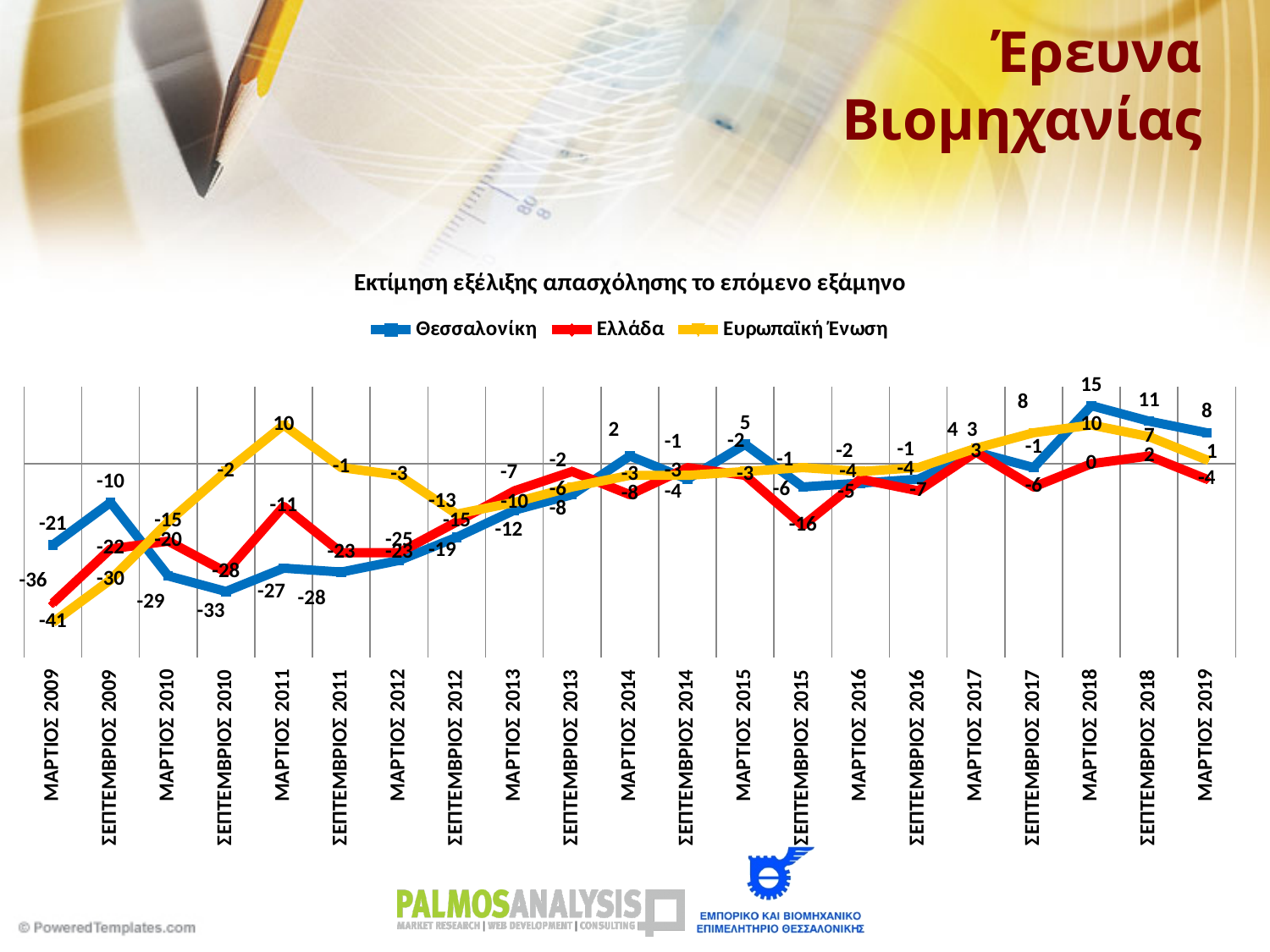
What is the value for Θεσσαλονίκη at ΜΑΡΤΙΟΣ 2018? 15 How many time points are plotted along the x axis of the chart? 21 Overall, does the Θεσσαλονίκη series rise or fall from ΜΑΡΤΙΟΣ 2009 to ΜΑΡΤΙΟΣ 2019? Rise What is the value for Ελλάδα at ΣΕΠΤΕΜΒΡΙΟΣ 2015? -16 What is the difference between the Θεσσαλονίκη value and the Ελλάδα value at ΜΑΡΤΙΟΣ 2018? 15 How many series does the chart legend list? 3 What is the title of the chart? Εκτίμηση εξέλιξης απασχόλησης το επόμενο εξάμηνο What kind of chart is shown on the slide? Line chart At ΜΑΡΤΙΟΣ 2011, which series has the higher value, Θεσσαλονίκη or Ευρωπαϊκή Ένωση? Ευρωπαϊκή Ένωση At which time point does the Θεσσαλονίκη series reach its lowest value? ΣΕΠΤΕΜΒΡΙΟΣ 2010 At which time point does the Θεσσαλονίκη series reach its highest value? ΜΑΡΤΙΟΣ 2018 What is the value for Ευρωπαϊκή Ένωση at ΜΑΡΤΙΟΣ 2009? -41